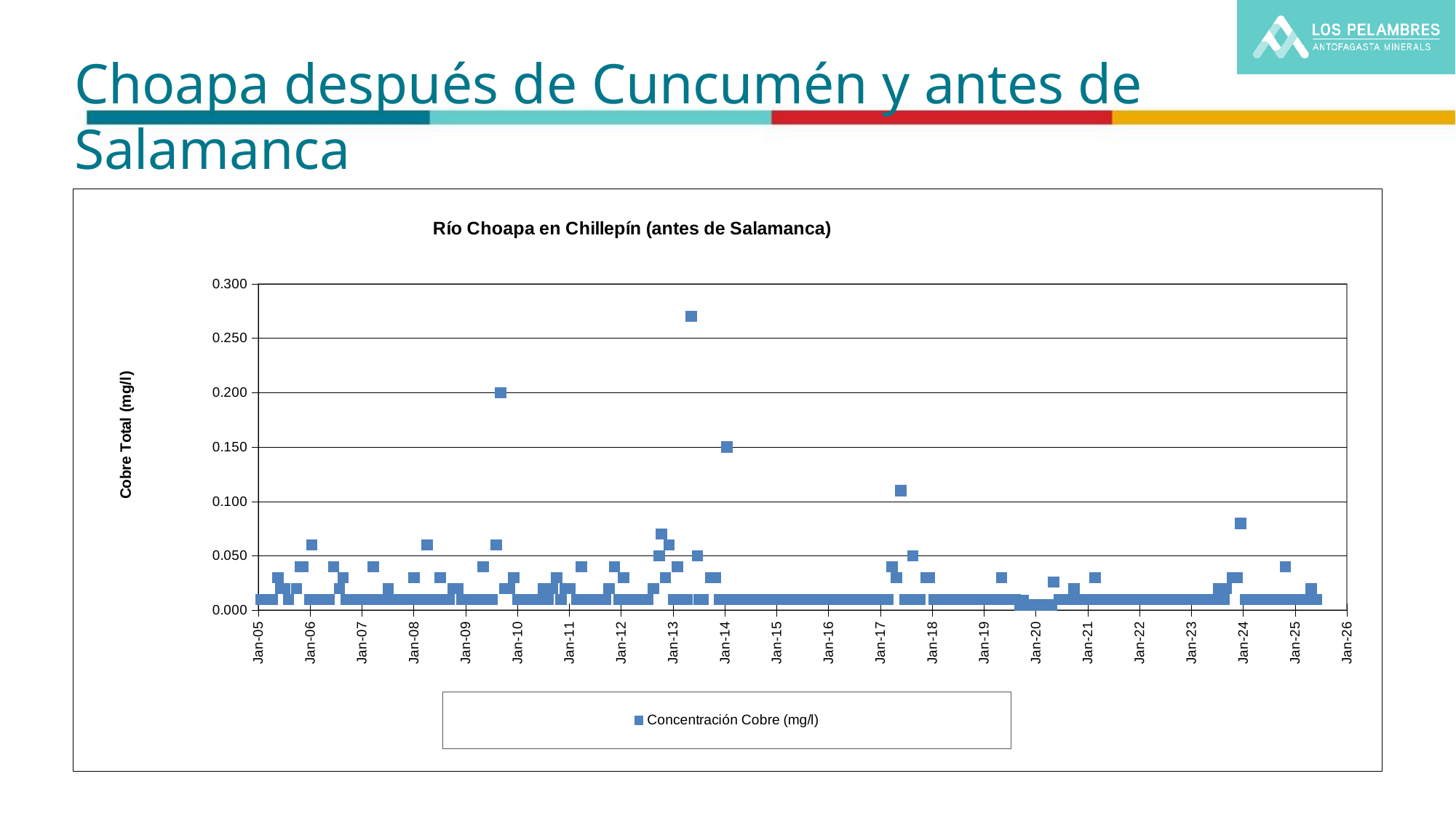
What is the legend entry for the plotted series? Concentración Cobre (mg/l) How many series does the legend list? 1 Is the highest plotted value greater or less than 0.250? greater Is the value plotted near Jan-14 greater or less than 0.100? greater What kind of chart is shown on the slide? scatter chart In which year does the highest plotted value occur? 2013 Which is larger, the peak value in 2009 or the peak value near Jan-14? 2009 Is the value plotted at Jan-16 greater or less than 0.050? less What is the title of the chart? Río Choapa en Chillepín (antes de Salamanca) Which is larger, the peak value in 2013 or the peak value in 2009? 2013